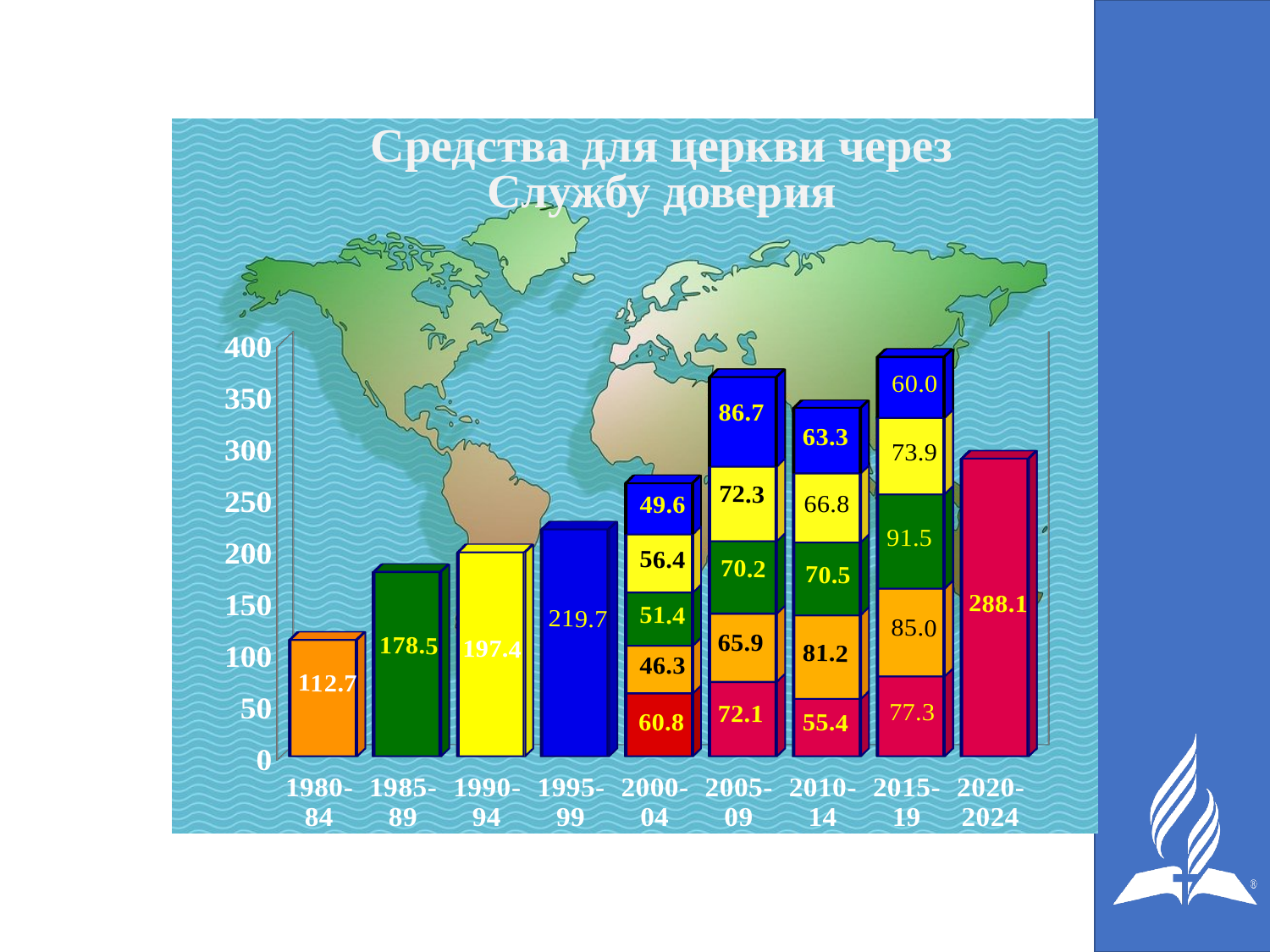
Do the bar values rise or fall from 1980-84 to 1995-99? rise What is the value of the bottom (red) segment of the 2000-04 bar? 60.8 What is the value of the top (blue) segment of the 2005-09 bar? 86.7 What is the total of the stacked bar for 2015-19? 387.7 Which period has the tallest bar? 2015-19 How many period categories are shown on the x axis? 9 What is the title of the chart? Средства для церкви через Службу доверия Which period has the lowest bar? 1980-84 What is the difference between the values for 1995-99 and 1990-94? 22.3 What kind of chart is shown on the slide? stacked bar chart What is the value for the 2020-2024 period? 288.1 What is the value for the 1980-84 period? 112.7